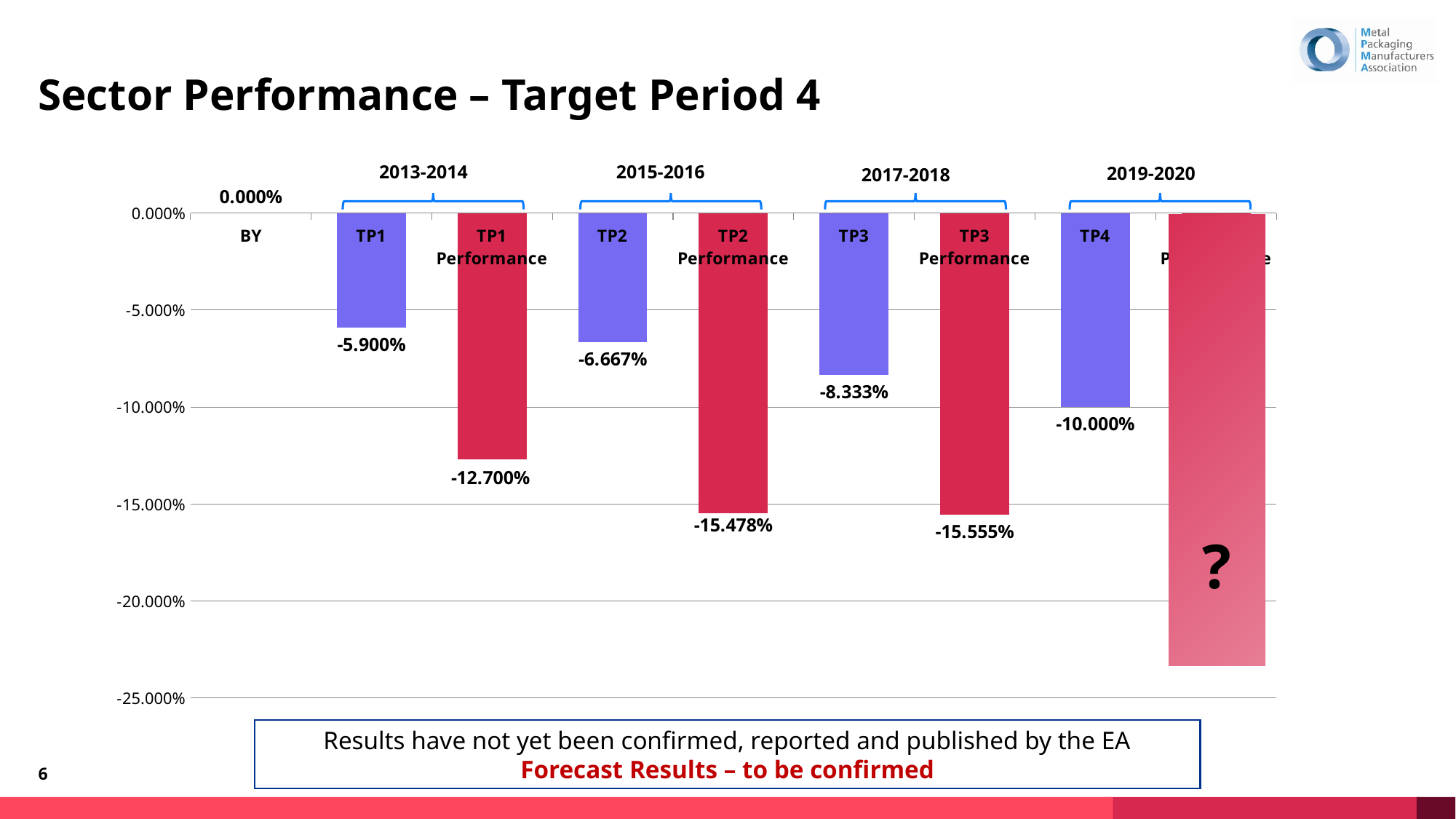
Among the target bars TP1, TP2, TP3 and TP4, which has the lowest (most negative) value? TP4 What is the value shown for TP4? -10.000% What is the value shown for BY? 0.000% What is the value shown for TP3? -8.333% What is the value shown for TP2 Performance? -15.478% How many bars are plotted in the chart? 9 What is the value shown for TP1? -5.900% Which is lower, TP2 Performance or TP3 Performance? TP3 Performance Do the target values from TP1 to TP4 rise or fall along the x axis? Fall Is the value of the 2019-2020 Performance bar (marked with a question mark) greater or less than -20.000%? less What kind of chart is shown on the slide? Bar chart What is the difference between the TP1 Performance value and the TP1 target value? 6.800 percentage points